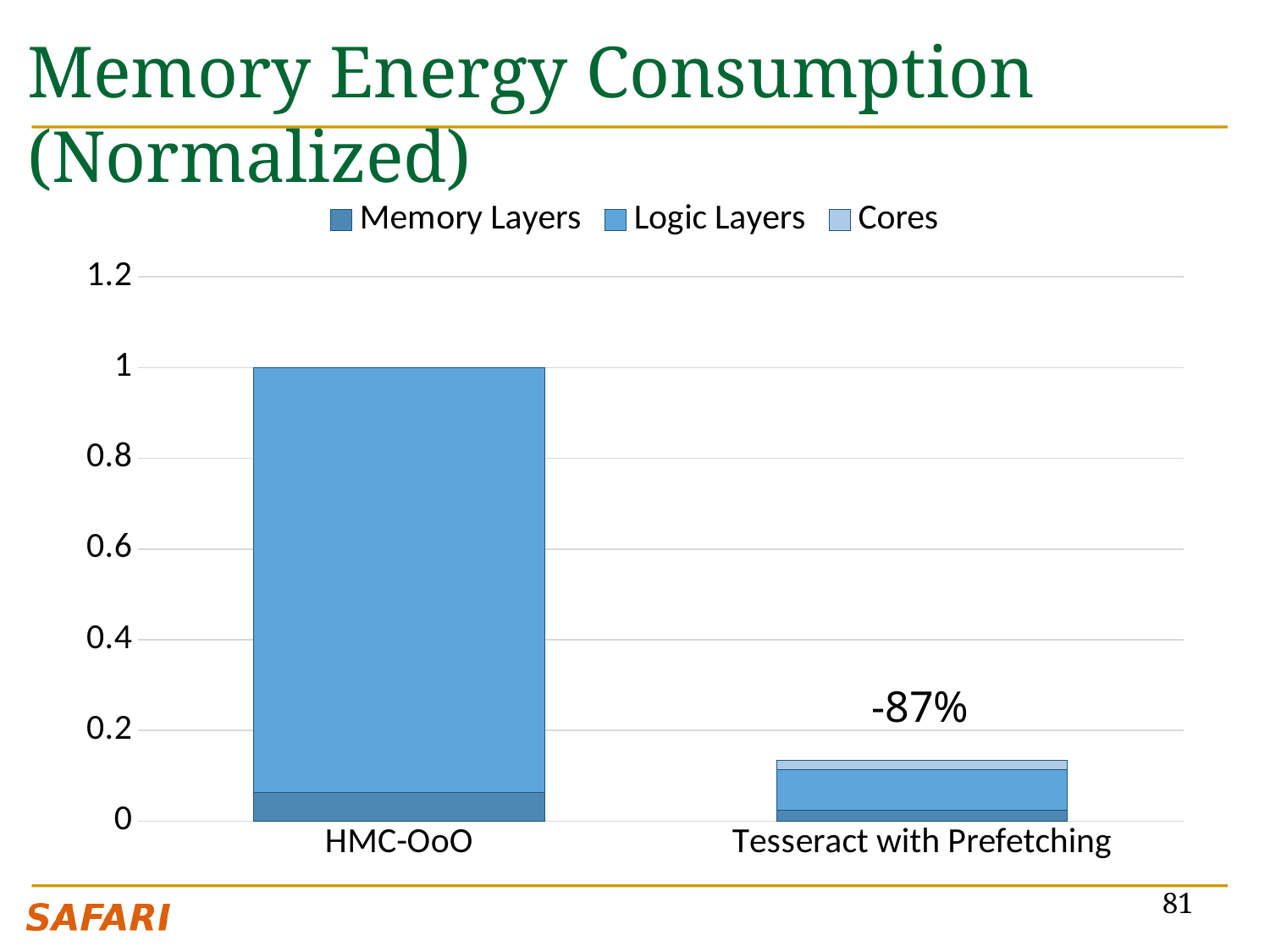
What is the total height of the stacked bar for HMC-OoO? 1 How many categories are shown on the x axis? 2 Which category has the lowest total normalized memory energy consumption? Tesseract with Prefetching What are the three legend entries of the chart? Memory Layers, Logic Layers, Cores Is the total value for Tesseract with Prefetching greater or less than 0.2? less What percentage change is annotated above the Tesseract with Prefetching bar? -87% Which has a larger total bar, HMC-OoO or Tesseract with Prefetching? HMC-OoO How many series does the legend list? 3 Which category has the highest total normalized memory energy consumption? HMC-OoO Is the Memory Layers value for HMC-OoO greater or less than 0.2? less Do the total bar values rise or fall from left to right along the x axis? fall What kind of chart is shown on the slide? bar chart